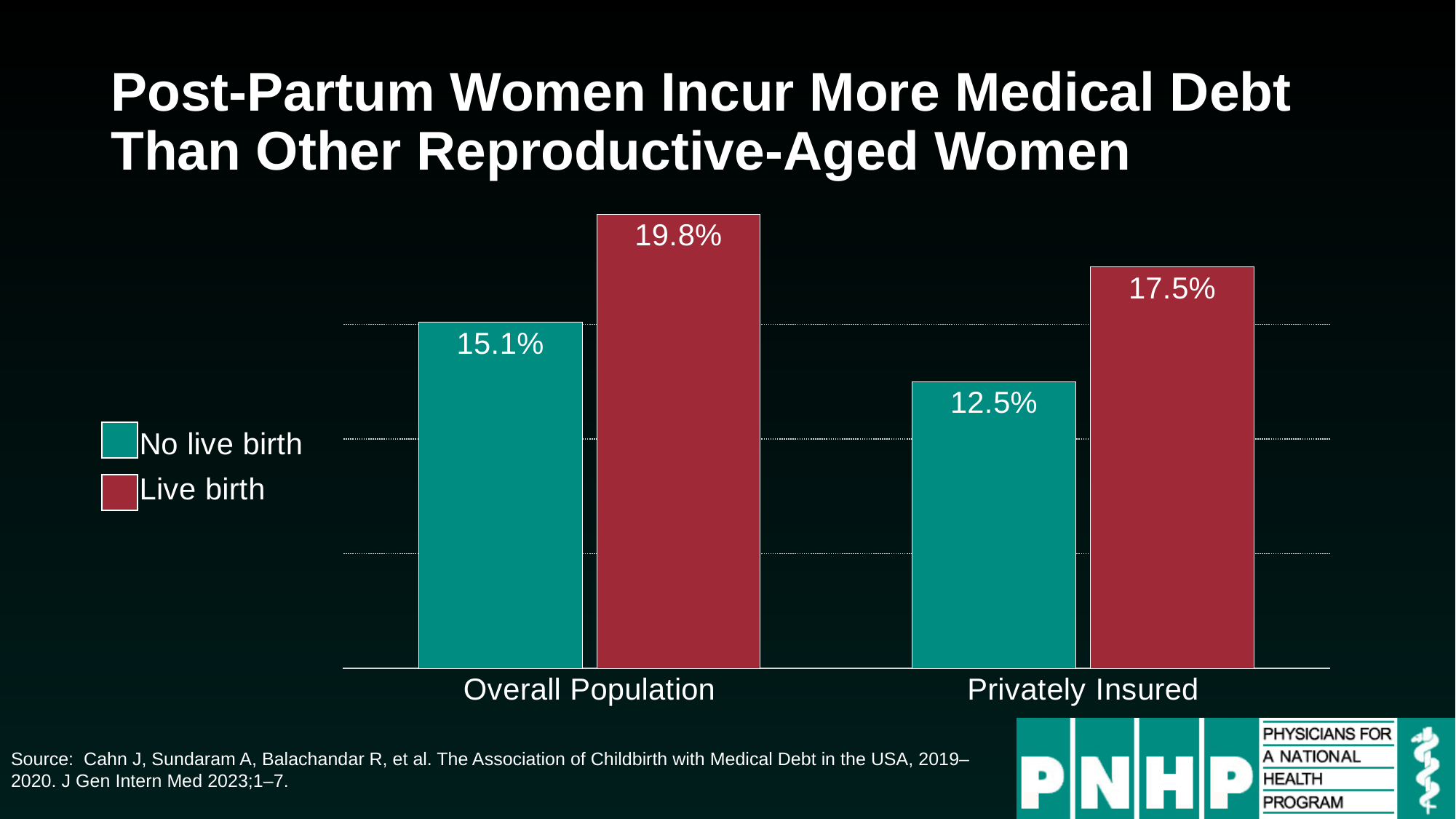
How many series does the legend list? 2 What kind of chart is shown on the slide? Bar chart What is the value for Live birth in the Privately Insured category? 17.5% What is the difference between the Live birth and No live birth values in the Overall Population category? 4.7% What is the value for Live birth in the Overall Population category? 19.8% Which is larger: the No live birth value for Overall Population or the Live birth value for Privately Insured? Live birth value for Privately Insured What is the value for No live birth in the Privately Insured category? 12.5% What is the difference between the Live birth and No live birth values in the Privately Insured category? 5.0% How many categories are shown on the x axis? 2 Which bar has the lowest value on the chart? No live birth, Privately Insured What is the value for No live birth in the Overall Population category? 15.1% Which bar has the highest value on the chart? Live birth, Overall Population